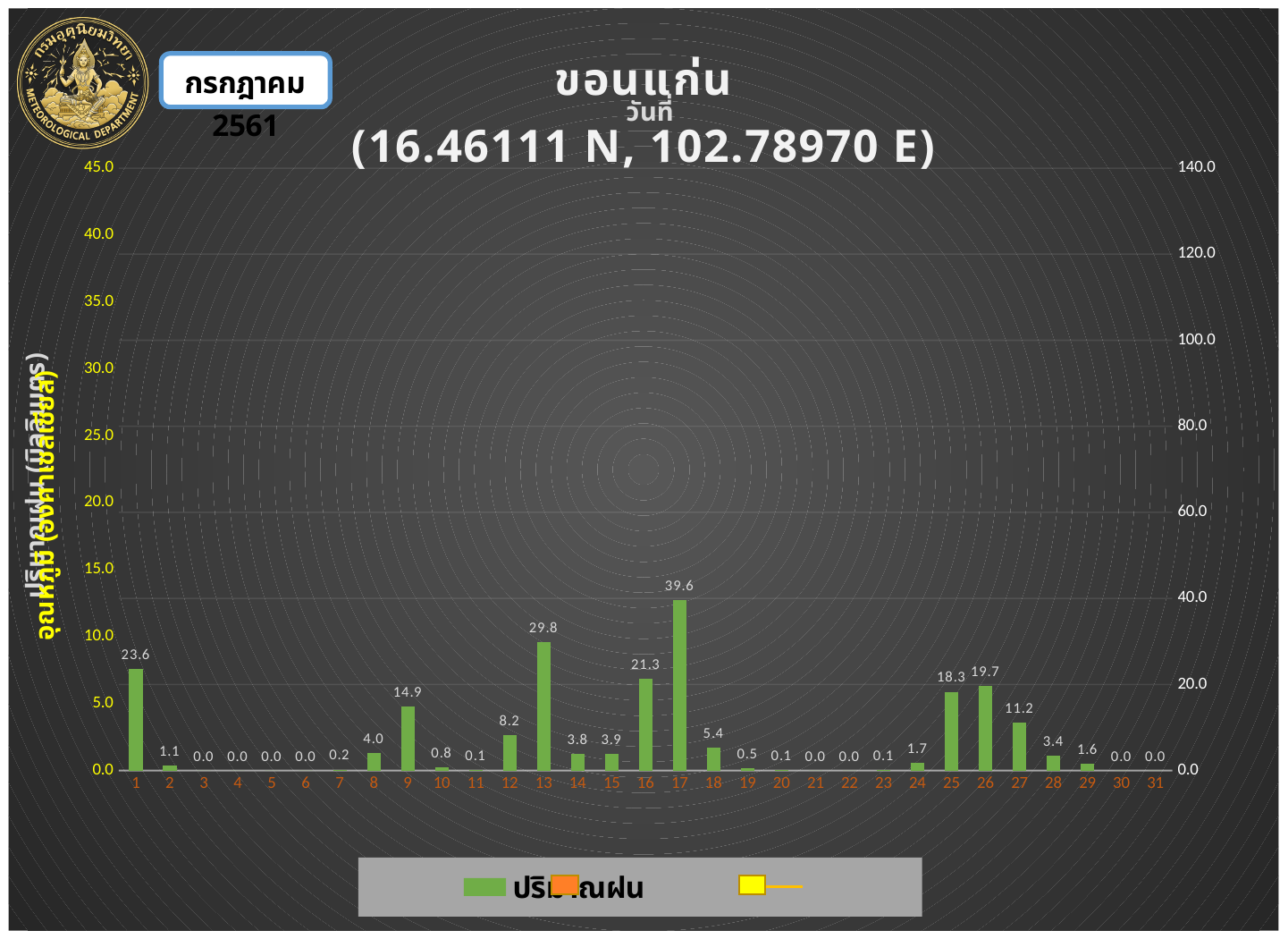
How many days are shown on the x axis? 31 Which has a larger rainfall value, day 9 or day 27? day 9 What is the rainfall value shown for day 17? 39.6 What colour are the rainfall bars in the chart? green Which day has the highest rainfall value? 17 Which has a larger rainfall value, day 16 or day 1? day 1 What is the difference between the rainfall values for day 25 and day 26? 1.4 What is the difference between the rainfall values for day 17 and day 13? 9.8 What is the rainfall value shown for day 1? 23.6 What kind of chart is shown on the slide? bar chart What is the rainfall value shown for day 13? 29.8 What is the rainfall value shown for day 26? 19.7